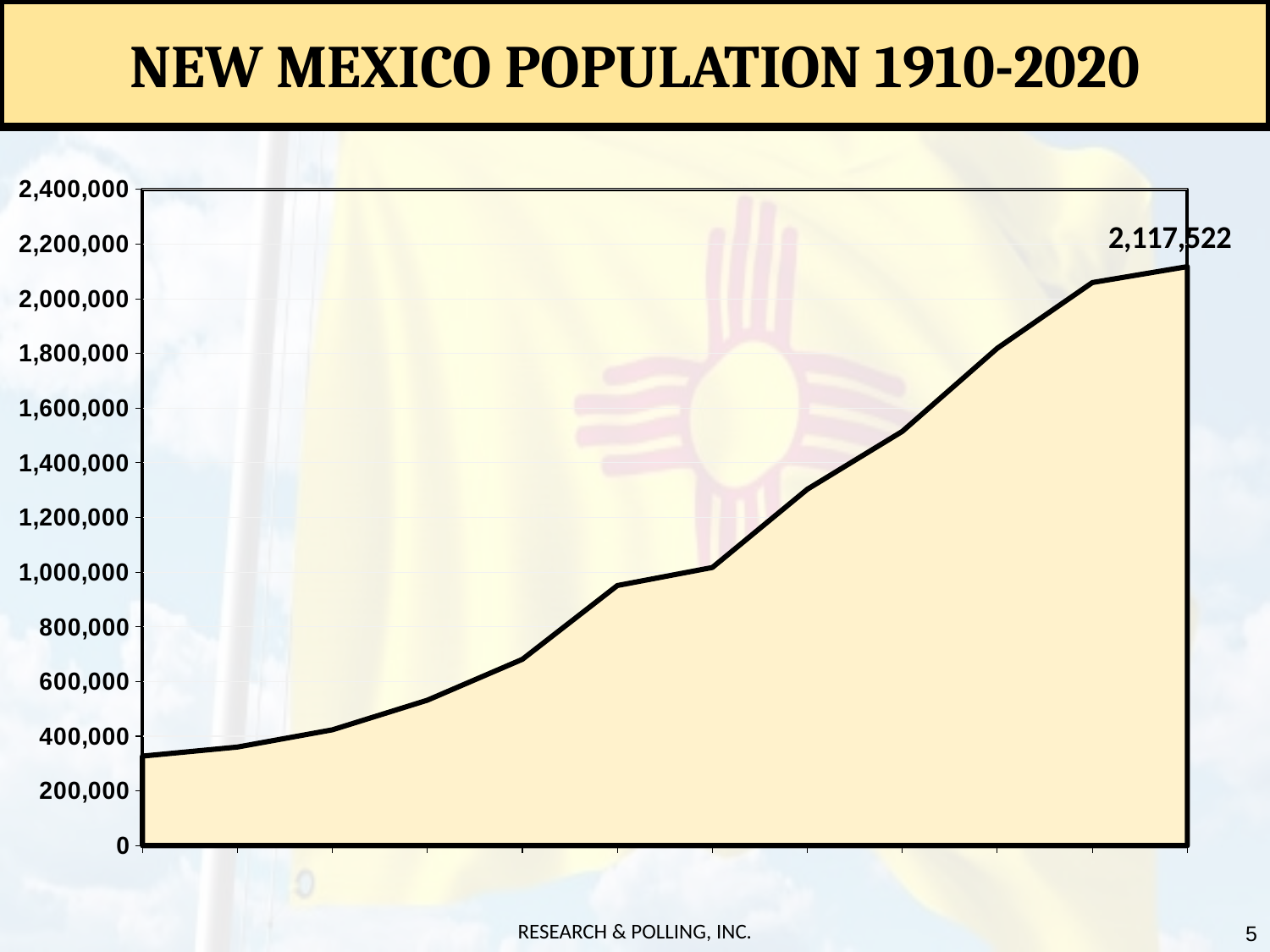
What is the highest value shown on the y axis? 2,400,000 Do the population values rise or fall from left to right along the x axis? Rise What is the highest population value shown on the chart? 2,117,522 Which is larger, the population at the first point on the left or at the last point on the right? The last point on the right What is the population value printed at the end of the line (the most recent year shown)? 2,117,522 Is the population value at the first point on the left greater or less than 400,000? less How many data points (x-axis tick marks) does the chart have? 12 What kind of chart is shown on the slide? Area chart Is the population value at the last point on the right greater or less than 2,000,000? greater What is the title of the chart? NEW MEXICO POPULATION 1910-2020 Is the population at the first point on the left greater or less than 200,000? greater